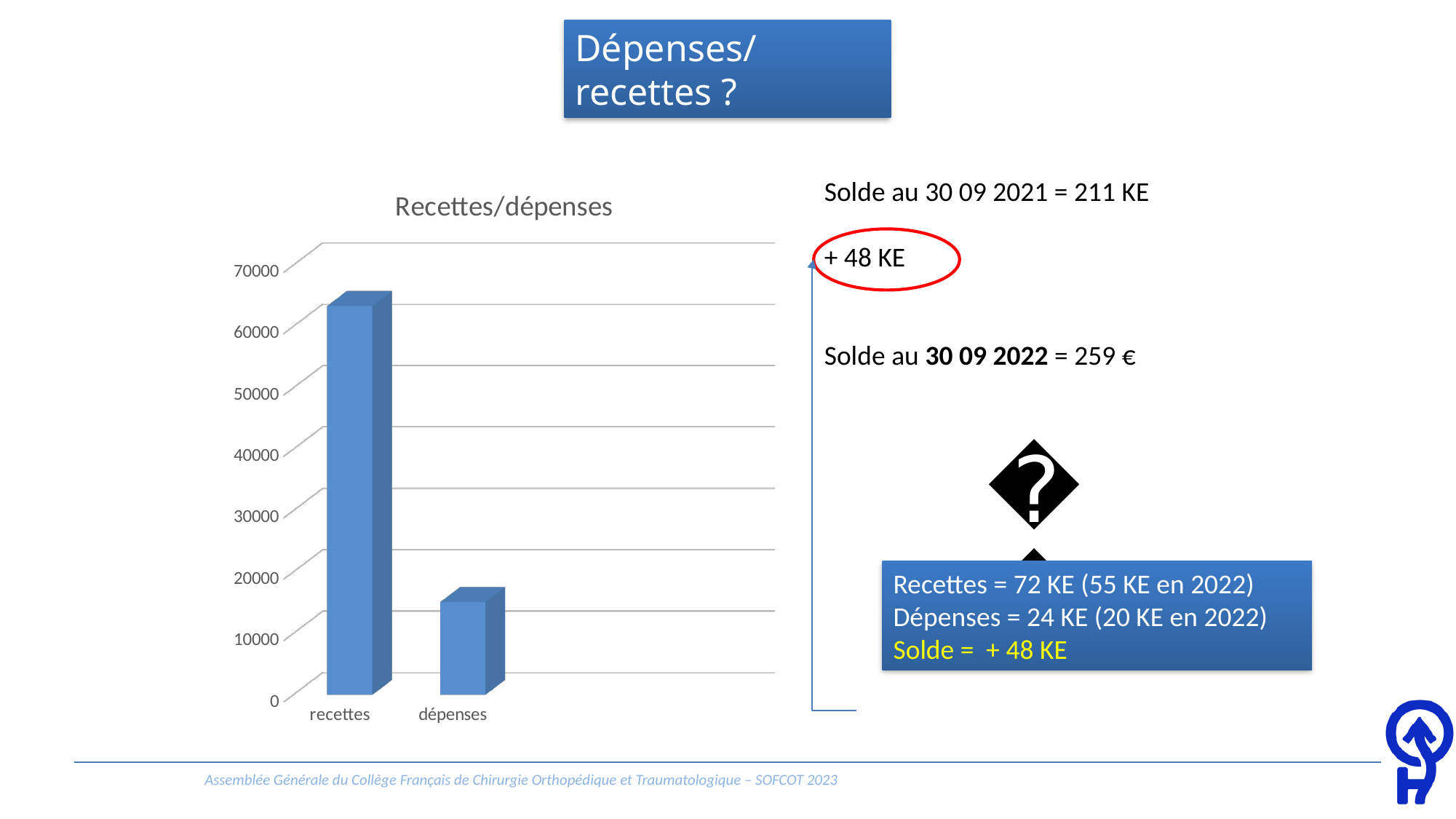
Which is larger in the chart, recettes or dépenses? recettes Is the value for dépenses greater or less than 20000? less Is the value for recettes greater or less than 50000? greater Is the value for dépenses greater or less than 10000? greater What is the title of the chart? Recettes/dépenses Which category has the highest value in the chart? recettes Which category has the lowest value in the chart? dépenses What is the highest value shown on the vertical axis of the chart? 70000 How many categories are plotted in the chart? 2 What kind of chart is shown on the slide? bar chart Do the values rise or fall from recettes to dépenses along the x axis? fall